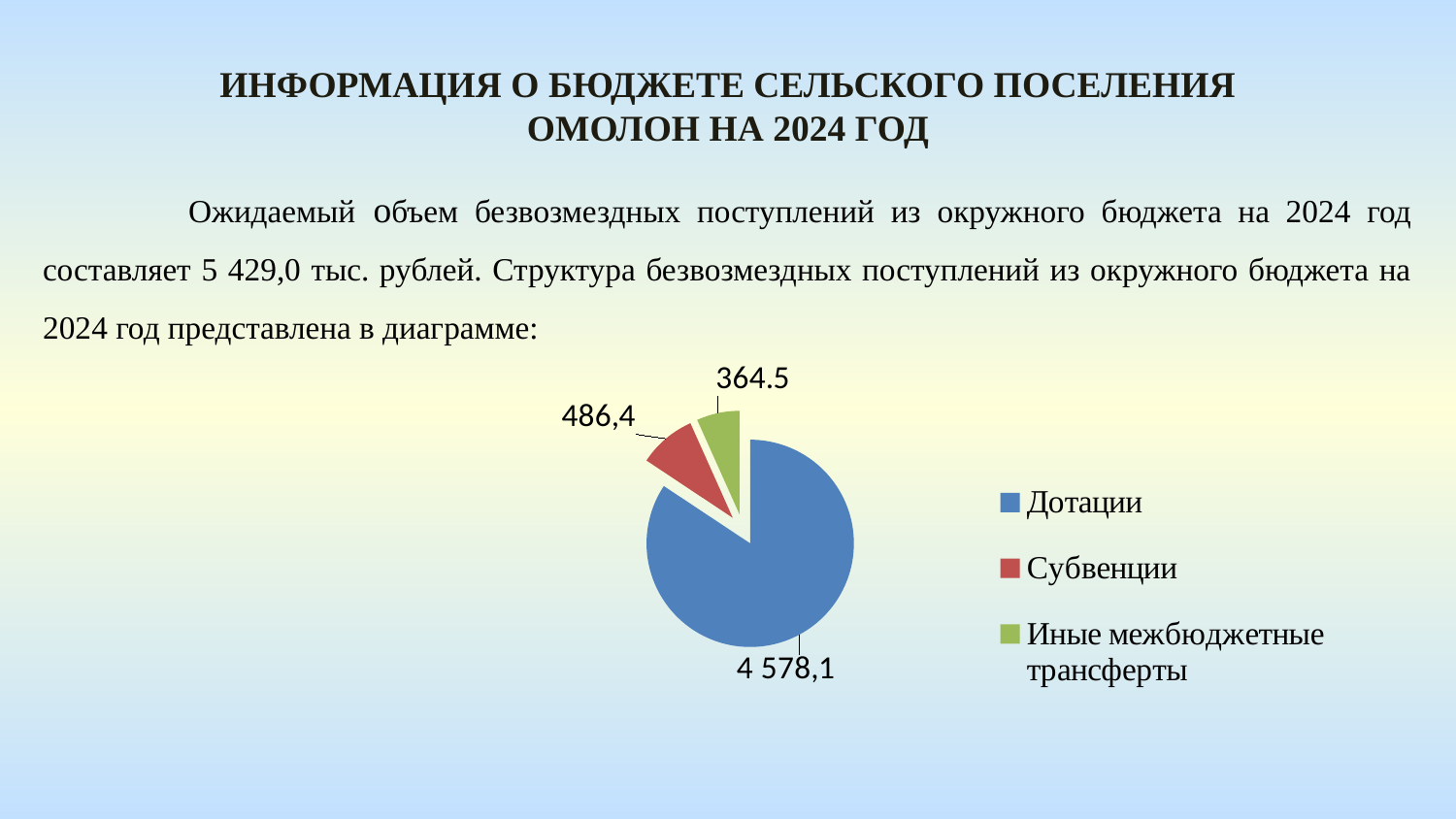
Which category has the smallest slice in the pie chart? Иные межбюджетные трансферты How many entries does the legend of the pie chart list? 3 What is the value shown for Субвенции in the pie chart? 486,4 What kind of chart is shown on the slide? pie chart What is the value shown for Дотации in the pie chart? 4 578,1 What is the difference between the values for Субвенции and Иные межбюджетные трансферты? 121,9 Which is larger in the pie chart, Субвенции or Иные межбюджетные трансферты? Субвенции What is the value shown for Иные межбюджетные трансферты in the pie chart? 364.5 Which colour represents Субвенции in the pie chart? red What is the difference between the values for Дотации and Субвенции? 4 091,7 Which category has the largest slice in the pie chart? Дотации How many slices does the pie chart have? 3